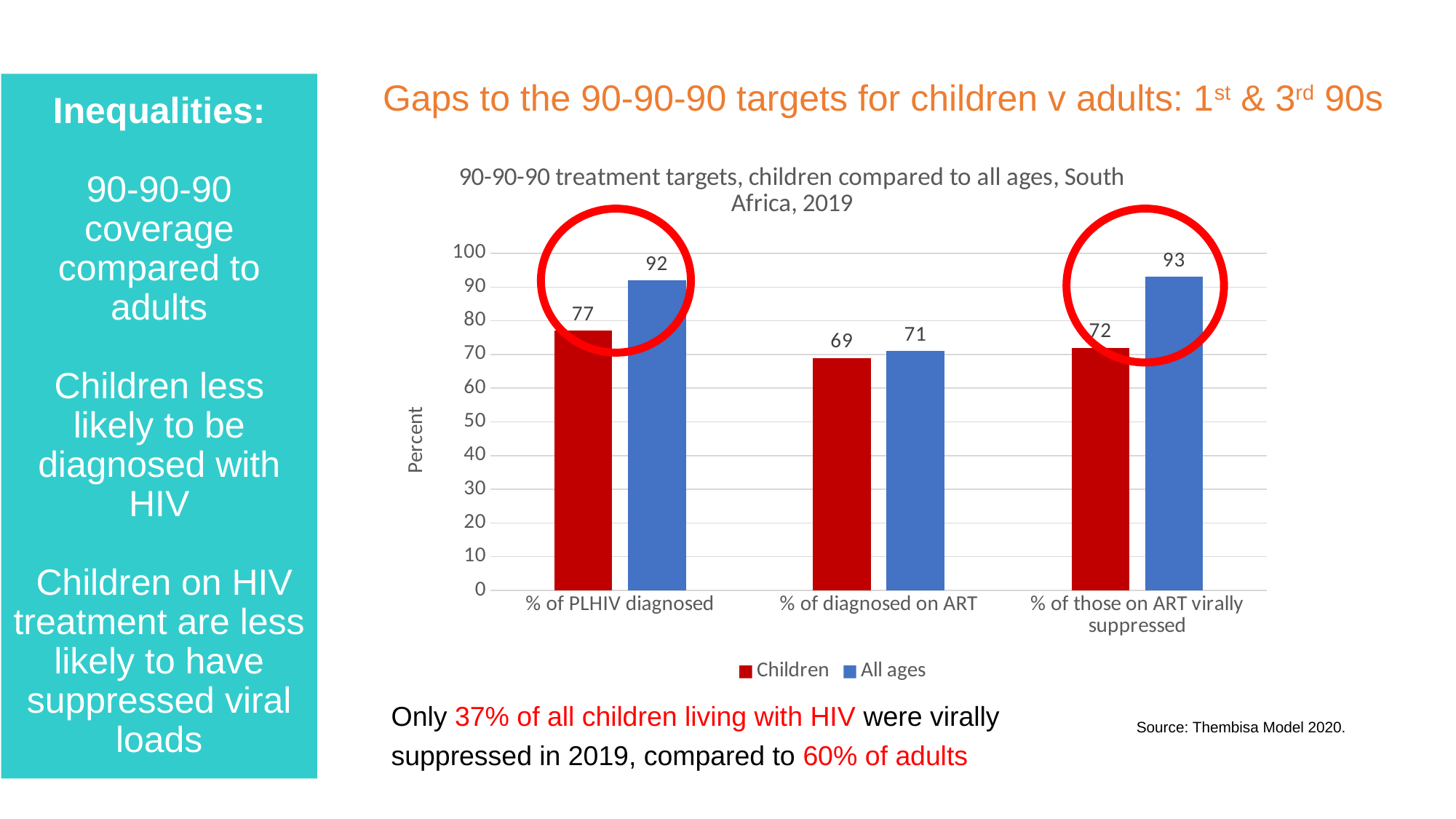
What is the difference between the All ages and Children values in the '% of PLHIV diagnosed' category? 15 What type of chart is shown on the slide? Bar chart Which category has the lowest value for the Children series? % of diagnosed on ART What is the value for Children in the '% of diagnosed on ART' category? 69 What is the value for All ages in the '% of those on ART virally suppressed' category? 93 Which category has the highest value for the All ages series? % of those on ART virally suppressed In the '% of diagnosed on ART' category, which series has the larger value, Children or All ages? All ages What is the value for Children in the '% of PLHIV diagnosed' category? 77 How many categories are shown on the x axis of the chart? 3 What is the difference between the All ages and Children values in the '% of those on ART virally suppressed' category? 21 What is the value for All ages in the '% of PLHIV diagnosed' category? 92 How many series does the chart legend list? 2